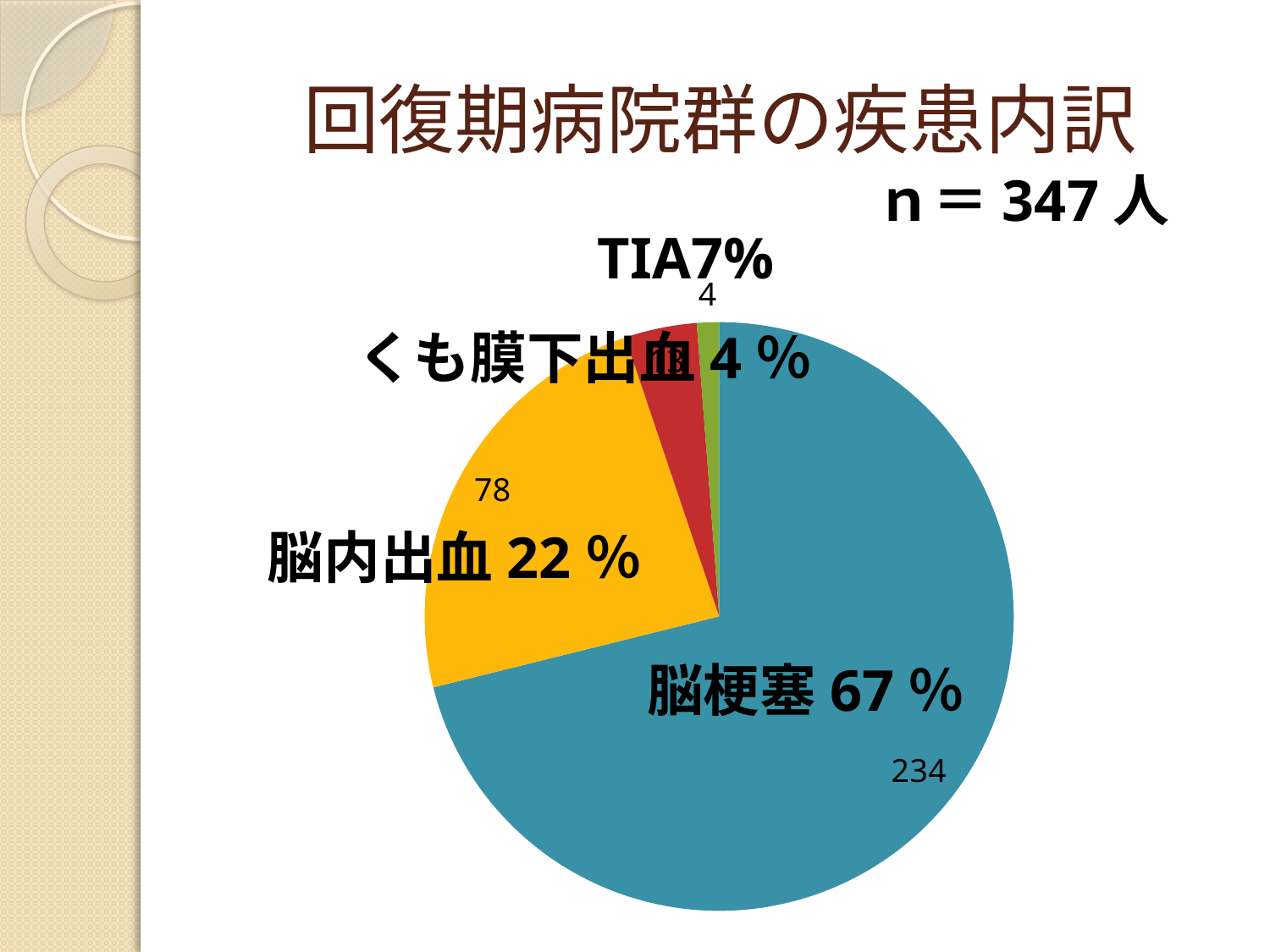
How many slices does the pie chart have? 4 Which category has the largest slice of the pie? 脳梗塞 What data label (number of people) is shown on the 脳梗塞 slice? 234 What percentage is shown for 脳内出血? 22% What percentage is shown for くも膜下出血? 4% What percentage is shown for 脳梗塞? 67% What data label (number of people) is shown on the 脳内出血 slice? 78 What kind of chart is shown on the slide? pie chart What is the difference between the number of people for 脳梗塞 and 脳内出血? 156 What is the total number of people (n) stated on the slide? 347 人 What is the title of the chart on the slide? 回復期病院群の疾患内訳 What percentage is shown for TIA? 7%